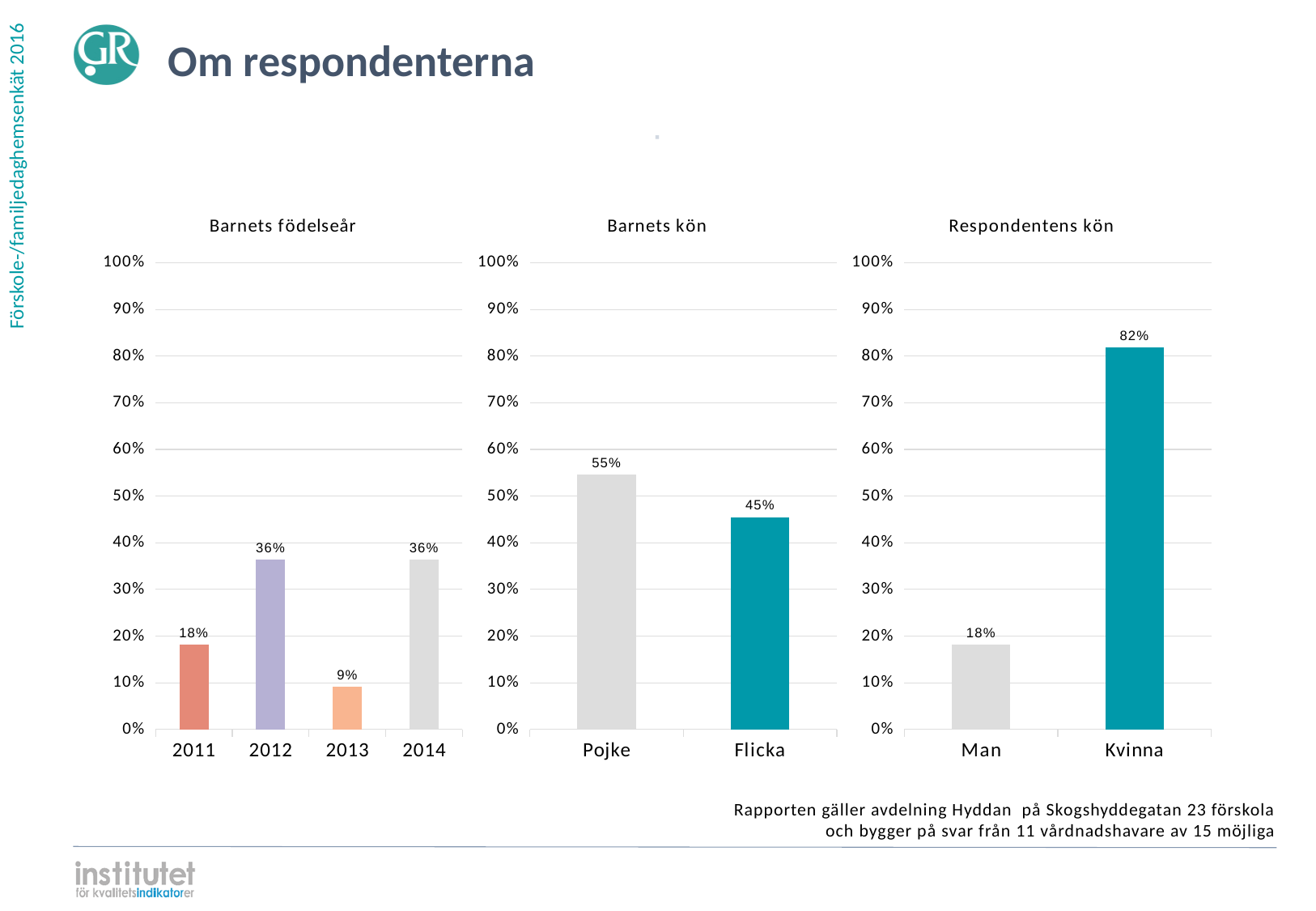
In the 'Respondentens kön' chart, which category has the highest value? Kvinna In the 'Barnets födelseår' chart, which year has the lowest value? 2013 In the 'Barnets kön' chart, what is the value for Pojke? 55% In the 'Respondentens kön' chart, what is the value for Kvinna? 82% In the 'Respondentens kön' chart, what is the difference between Kvinna and Man? 64% In the 'Barnets kön' chart, what is the difference between Pojke and Flicka? 10% What is the title of the leftmost chart on the slide? Barnets födelseår In the 'Barnets födelseår' chart, how many years are shown on the x axis? 4 In the 'Barnets födelseår' chart, what is the value for 2011? 18% In the 'Barnets födelseår' chart, what is the difference between the values for 2012 and 2013? 27% In the 'Barnets kön' chart, which category is higher, Pojke or Flicka? Pojke What kind of chart is the 'Respondentens kön' chart? Bar chart